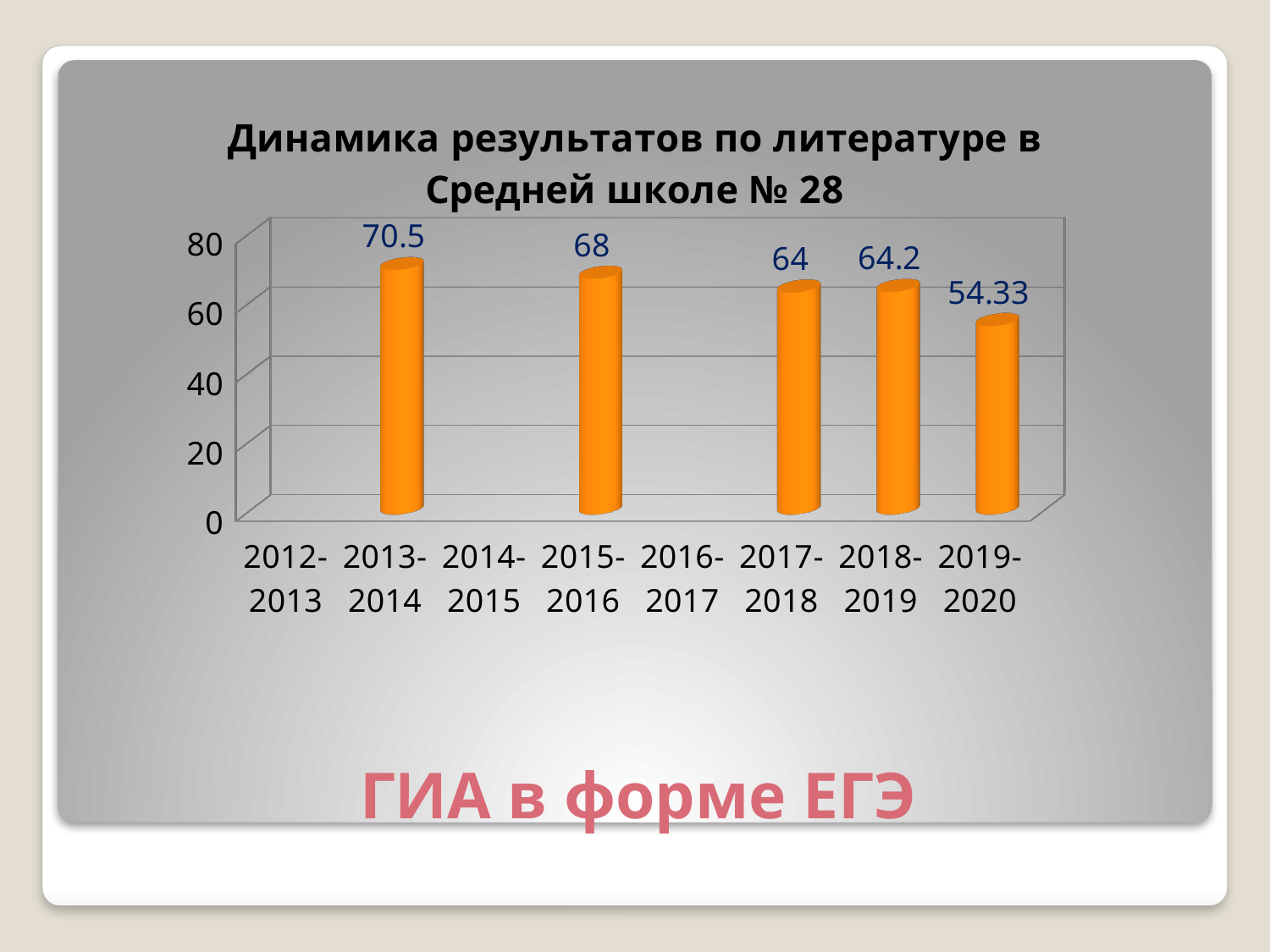
Is the value for 2018-2019 greater or less than 60? greater What is the difference between the values for 2013-2014 and 2019-2020? 16.17 Which academic year has the lowest value among the plotted bars? 2019-2020 What is the title of the chart? Динамика результатов по литературе в Средней школе № 28 What is the value for 2013-2014? 70.5 Which academic year has the highest value? 2013-2014 What is the value for 2019-2020? 54.33 What is the difference between the values for 2015-2016 and 2017-2018? 4 What kind of chart is shown on the slide? bar chart What is the value for 2017-2018? 64 Which is larger, the value for 2015-2016 or the value for 2019-2020? 2015-2016 How many bars are plotted on the chart? 5